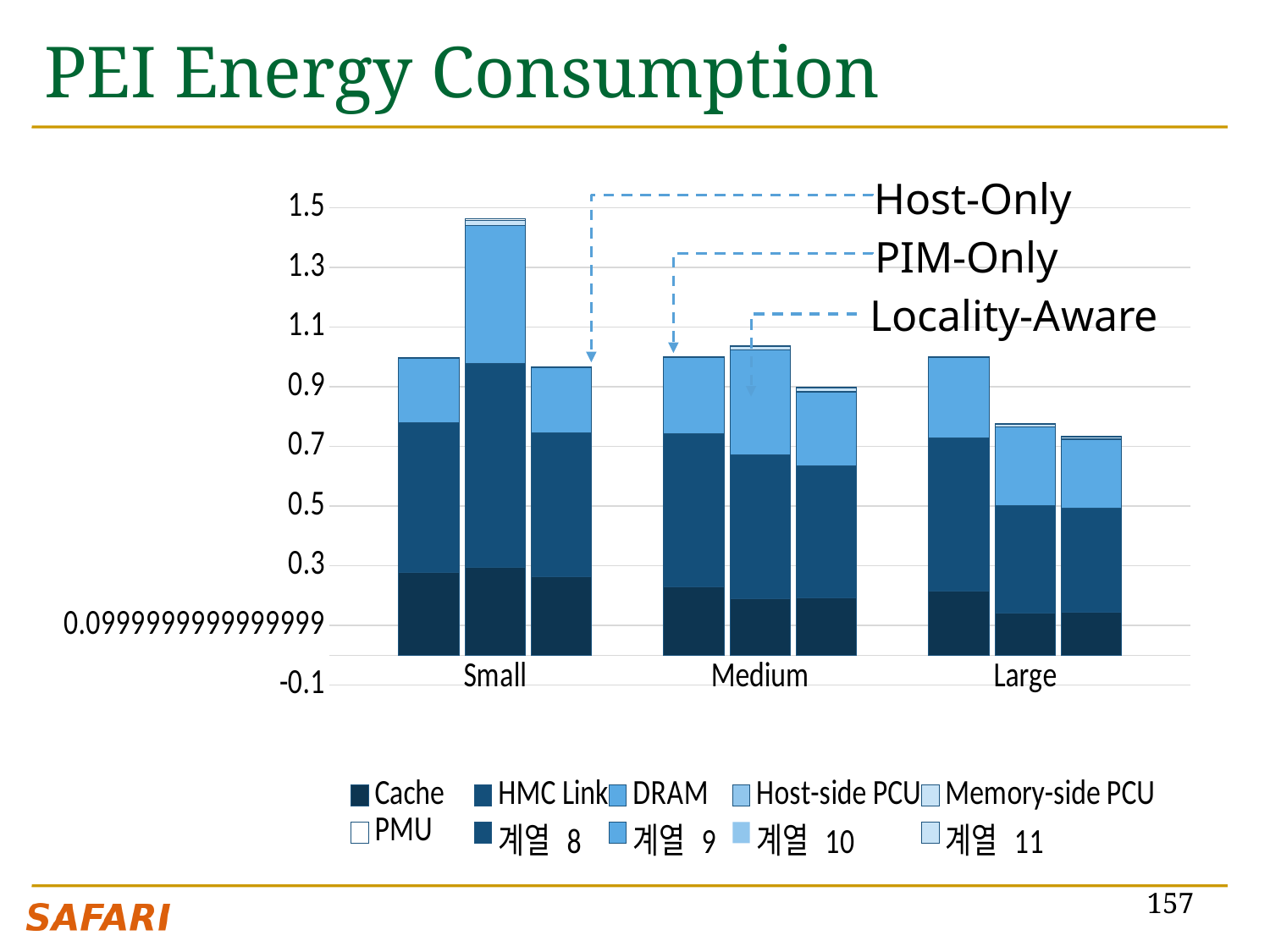
Is the total of the Locality-Aware bar for Large greater or less than 0.9? less Is the total of the PIM-Only bar for Large greater or less than 0.9? less Do the Locality-Aware bar totals rise or fall from Small to Large? fall How many series does the legend list? 10 How many categories are shown on the x axis? 3 What is the title of the chart? PEI Energy Consumption What are the three category labels on the x axis? Small, Medium, Large Which is taller: the PIM-Only bar for Small or the PIM-Only bar for Medium? Small What kind of chart is shown on the slide? stacked bar chart Is the total of the PIM-Only bar for Small greater or less than 1.3? greater Which category has the shortest Locality-Aware bar? Large Which category has the tallest PIM-Only bar? Small